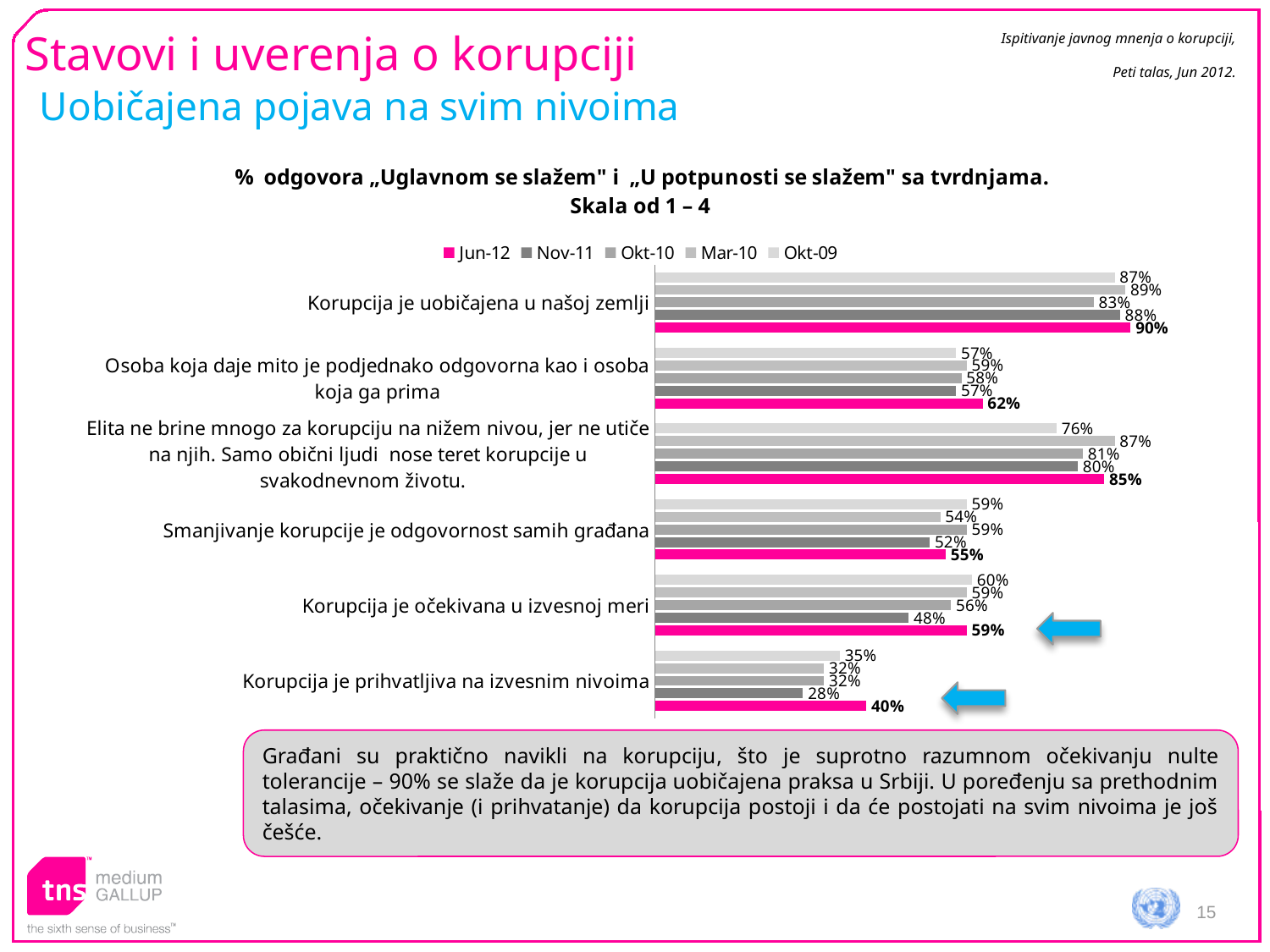
What type of chart is shown on the slide? Bar chart What is the Jun-12 value for "Smanjivanje korupcije je odgovornost samih građana"? 55% By how many percentage points is the Jun-12 value for "Korupcija je očekivana u izvesnoj meri" higher than the Nov-11 value? 11 percentage points In Jun-12, which statement has the larger value: "Elita ne brine mnogo za korupciju na nižem nivou..." or "Osoba koja daje mito je podjednako odgovorna kao i osoba koja ga prima"? Elita ne brine mnogo za korupciju na nižem nivou... By how many percentage points did the value for "Korupcija je prihvatljiva na izvesnim nivoima" change from Nov-11 to Jun-12? 12 percentage points What is the Jun-12 value for "Korupcija je uobičajena u našoj zemlji"? 90% How many statements (categories) are shown in the chart? 6 How many series (survey waves) does the legend list? 5 What is the Jun-12 value for "Korupcija je prihvatljiva na izvesnim nivoima"? 40% Which statement has the lowest Jun-12 value? Korupcija je prihvatljiva na izvesnim nivoima Which statement has the highest Jun-12 value? Korupcija je uobičajena u našoj zemlji What is the Nov-11 value for "Korupcija je očekivana u izvesnoj meri"? 48%